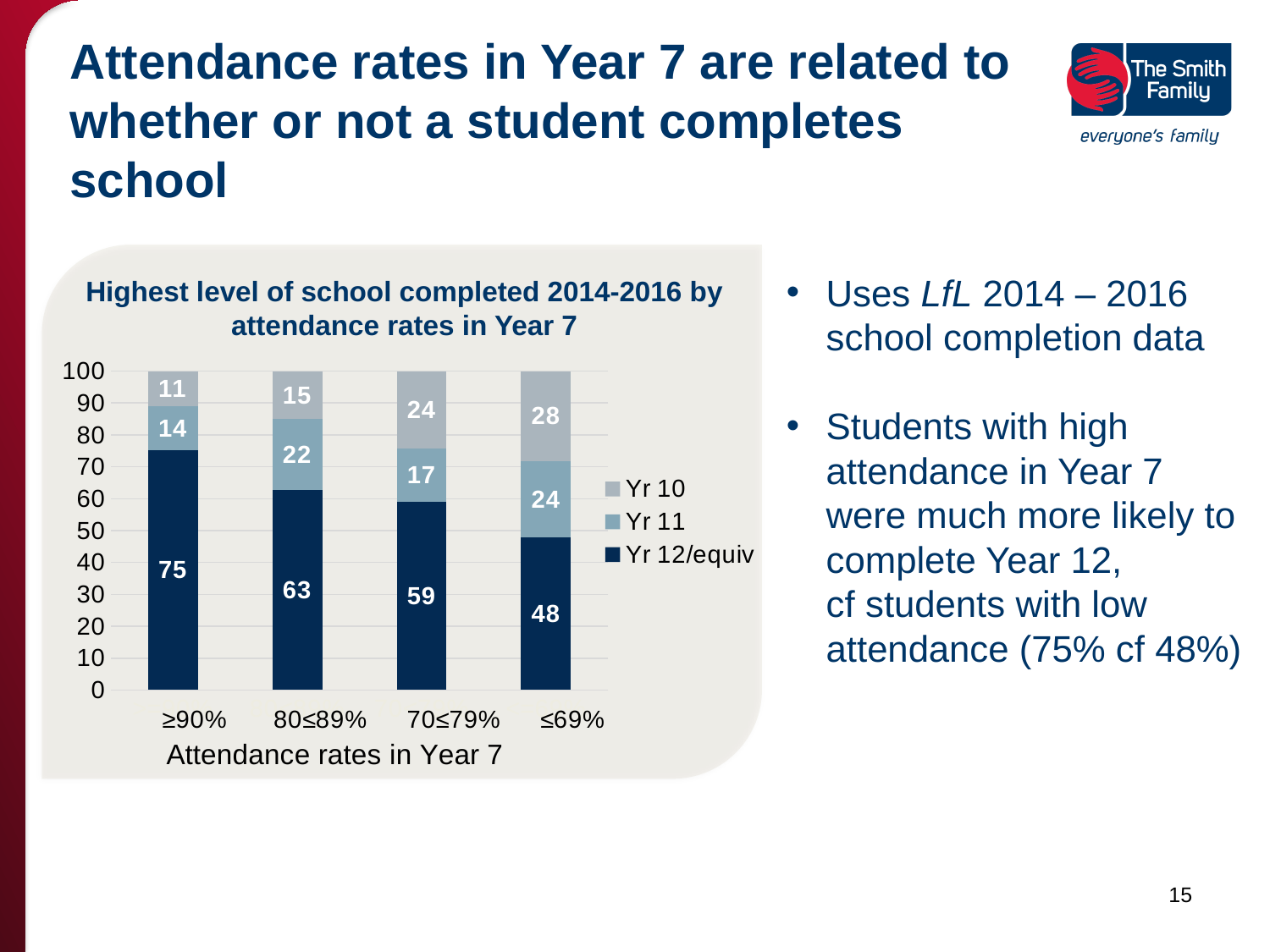
How many attendance categories are shown on the x axis? 4 Do the Yr 12/equiv values rise or fall as attendance rates decrease from ≥90% to ≤69%? Fall Which attendance category has the highest Yr 12/equiv value? ≥90% What is the Yr 12/equiv value for the ≥90% attendance category? 75 Which is larger, the Yr 11 value for 70≤79% or the Yr 11 value for ≤69%? ≤69% How many series does the legend list? 3 What is the Yr 11 value for the 80≤89% attendance category? 22 What is the title of the chart? Highest level of school completed 2014-2016 by attendance rates in Year 7 What kind of chart is shown on the slide? Stacked bar chart What is the difference between the Yr 12/equiv values for ≥90% and ≤69%? 27 Which attendance category has the lowest Yr 10 value? ≥90% What is the Yr 10 value for the ≤69% attendance category? 28